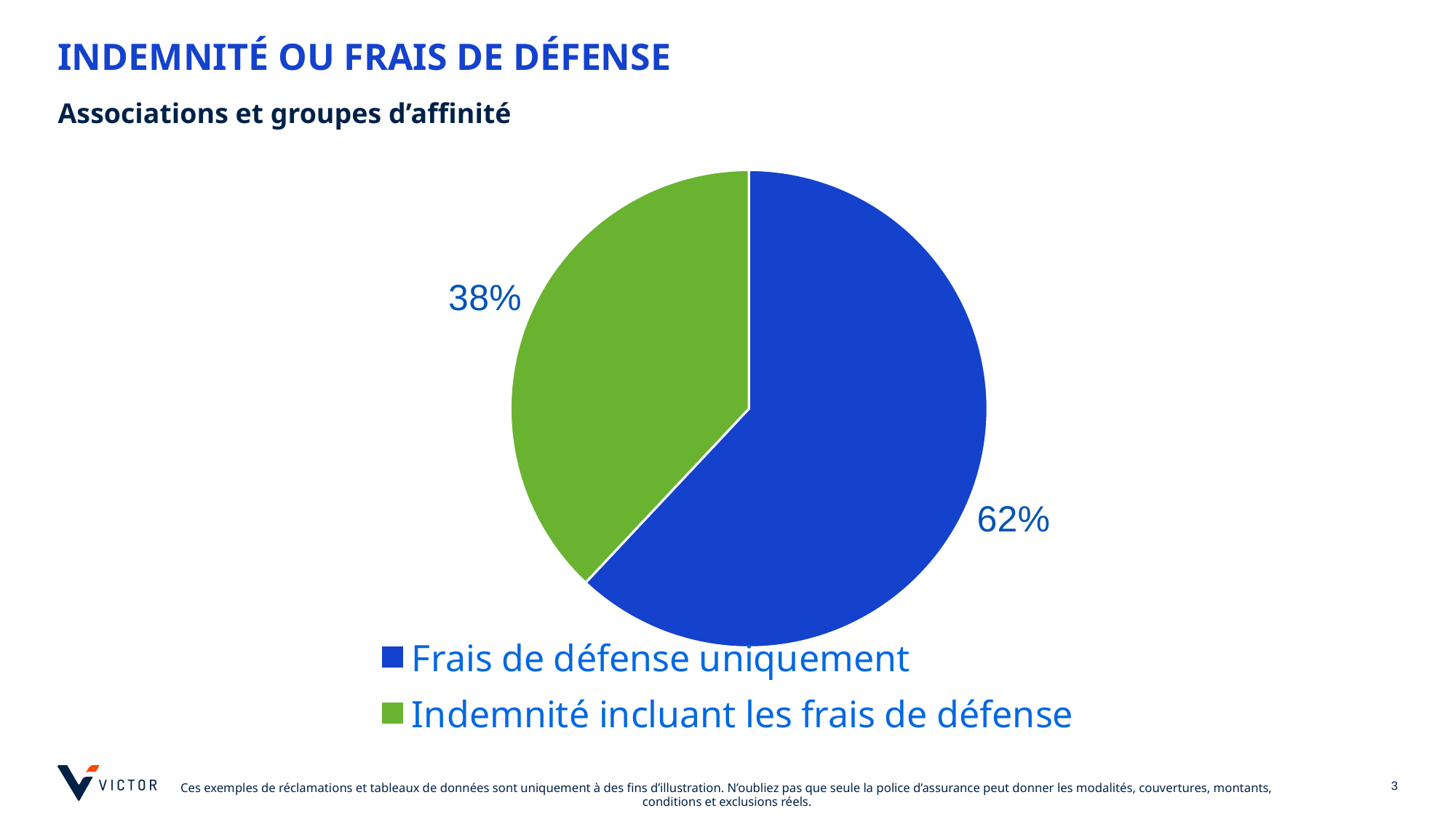
How many entries does the legend list? 2 What is the difference in percentage points between 'Frais de défense uniquement' and 'Indemnité incluant les frais de défense'? 24 What kind of chart is shown on the slide? Pie chart Which is larger: 'Frais de défense uniquement' or 'Indemnité incluant les frais de défense'? Frais de défense uniquement What is the subtitle shown above the chart? Associations et groupes d'affinité What share of the pie is 'Frais de défense uniquement'? 62% What colour is the 'Indemnité incluant les frais de défense' slice? Green What is the total of the two slices shown? 100% Which slice is the smallest? Indemnité incluant les frais de défense What share of the pie is 'Indemnité incluant les frais de défense'? 38% How many slices does the pie chart have? 2 Which slice is the largest? Frais de défense uniquement